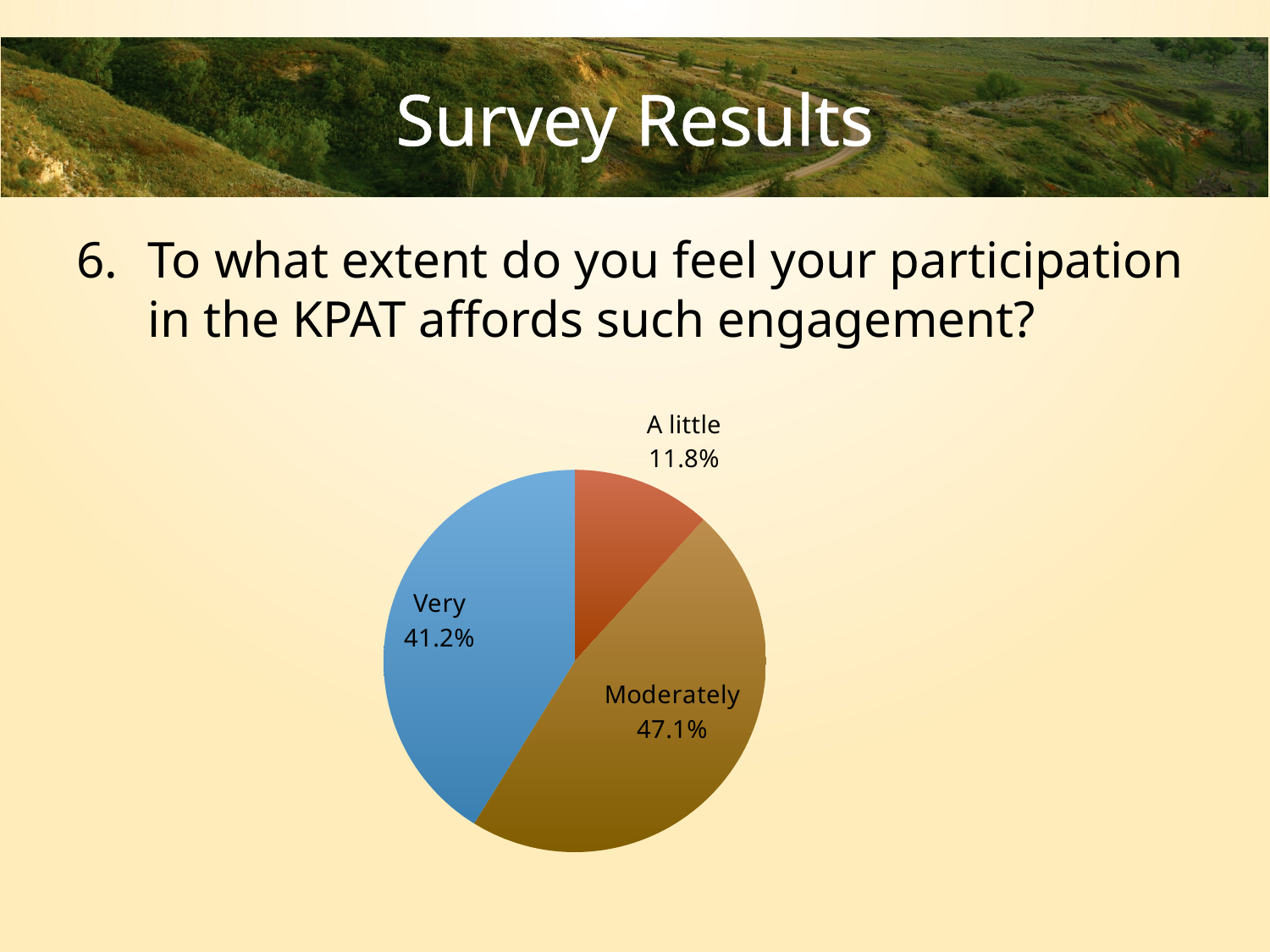
What colour is the "Very" slice of the pie? blue Which response has the smallest share of the pie? A little How many slices does the pie chart have? 3 Which response has the largest share of the pie? Moderately What is the difference in percentage points between "Moderately" and "Very"? 5.9 What kind of chart is shown on the slide? pie chart What percentage of respondents answered "Moderately"? 47.1% What percentage of respondents answered "Very"? 41.2% What colour is the "A little" slice of the pie? red What is the difference in percentage points between "Very" and "A little"? 29.4 What percentage of respondents answered "A little"? 11.8% Which is larger, the share for "Very" or the share for "A little"? Very